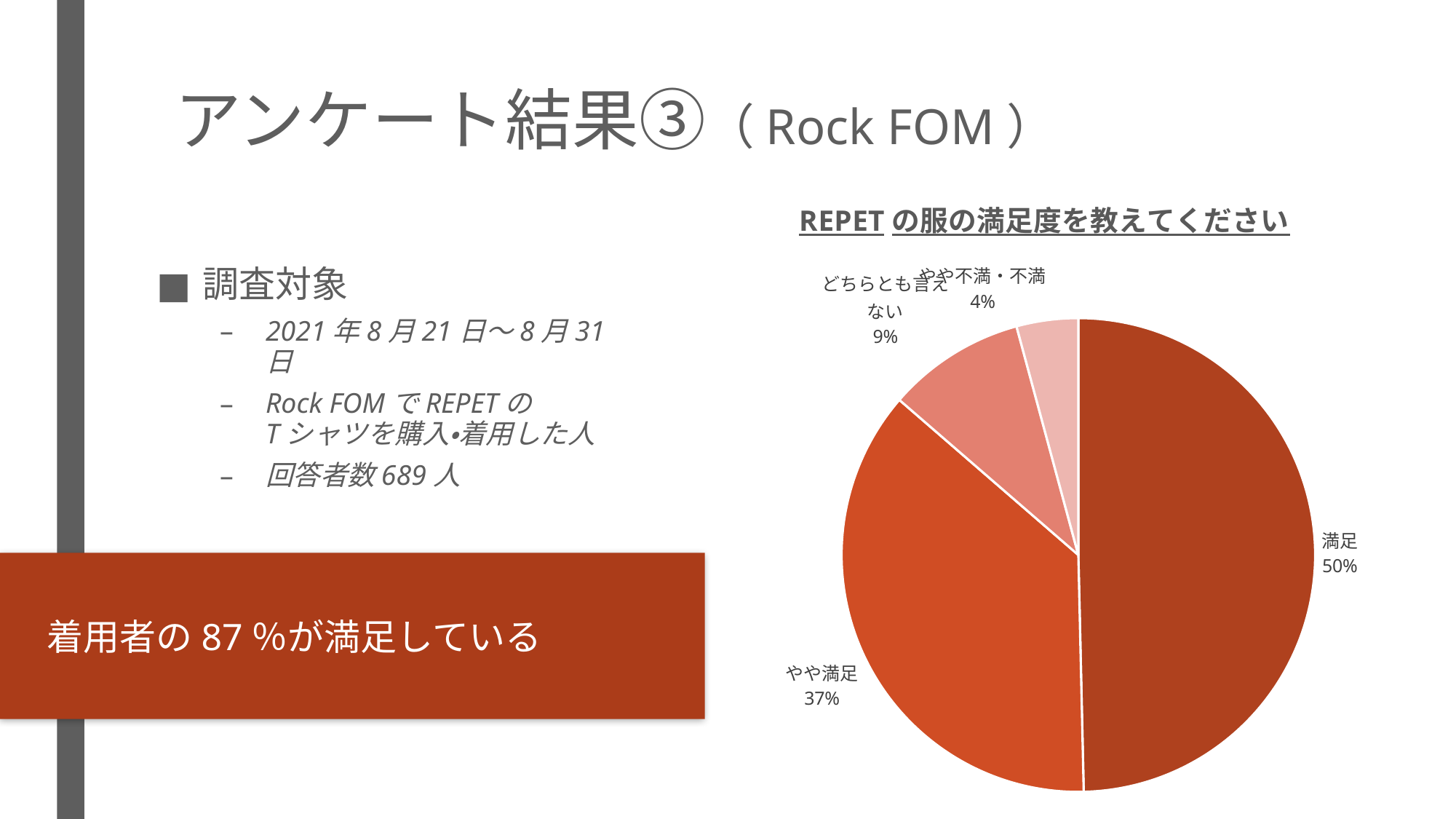
What share of the pie does 満足 represent? 50% Which category has the smallest slice of the pie? やや不満・不満 How many categories are shown in the pie chart? 4 What kind of chart is shown on the slide? Pie chart What share of the pie does どちらとも言えない represent? 9% Which is larger, the share for どちらとも言えない or the share for やや不満・不満? どちらとも言えない What is the title of the pie chart? REPET の服の満足度を教えてください What is the combined share of 満足 and やや満足? 87% What share of the pie does やや満足 represent? 37% Which category has the largest slice of the pie? 満足 What is the difference between the shares for 満足 and やや満足? 13%